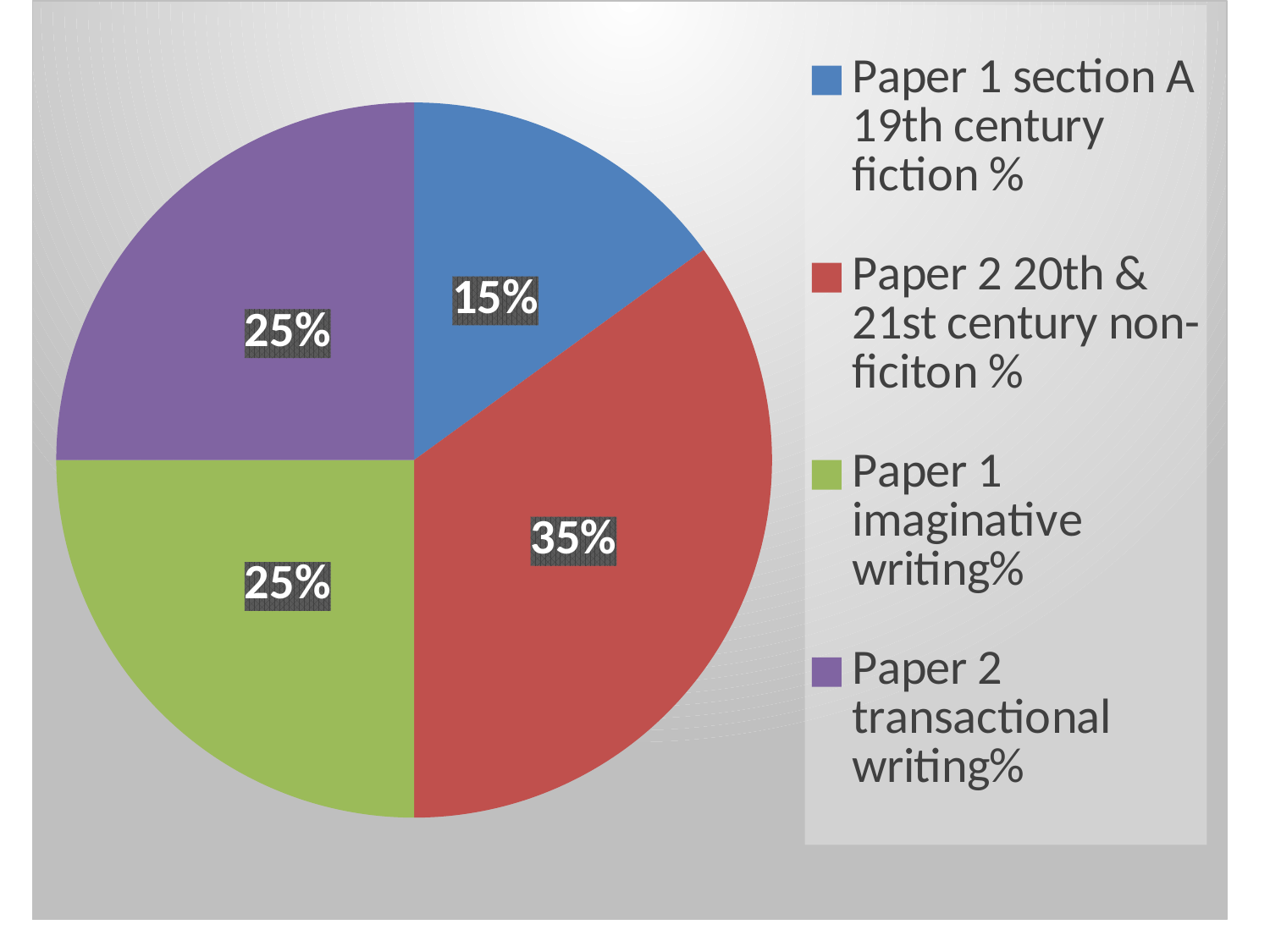
What is the difference in percentage points between Paper 2 20th & 21st century non-fiction and Paper 1 section A 19th century fiction? 20 What percentage is shown for Paper 1 imaginative writing? 25% What percentage is shown for Paper 2 20th & 21st century non-fiction? 35% How many entries does the legend list? 4 How many slices does the pie chart have? 4 What colour is the slice for Paper 2 transactional writing? purple Which category has the smallest share of the pie? Paper 1 section A 19th century fiction Which is larger: Paper 1 imaginative writing or Paper 1 section A 19th century fiction? Paper 1 imaginative writing Which category has the largest share of the pie? Paper 2 20th & 21st century non-fiction What percentage is shown for Paper 1 section A 19th century fiction? 15% What percentage is shown for Paper 2 transactional writing? 25% What kind of chart is shown on the slide? pie chart